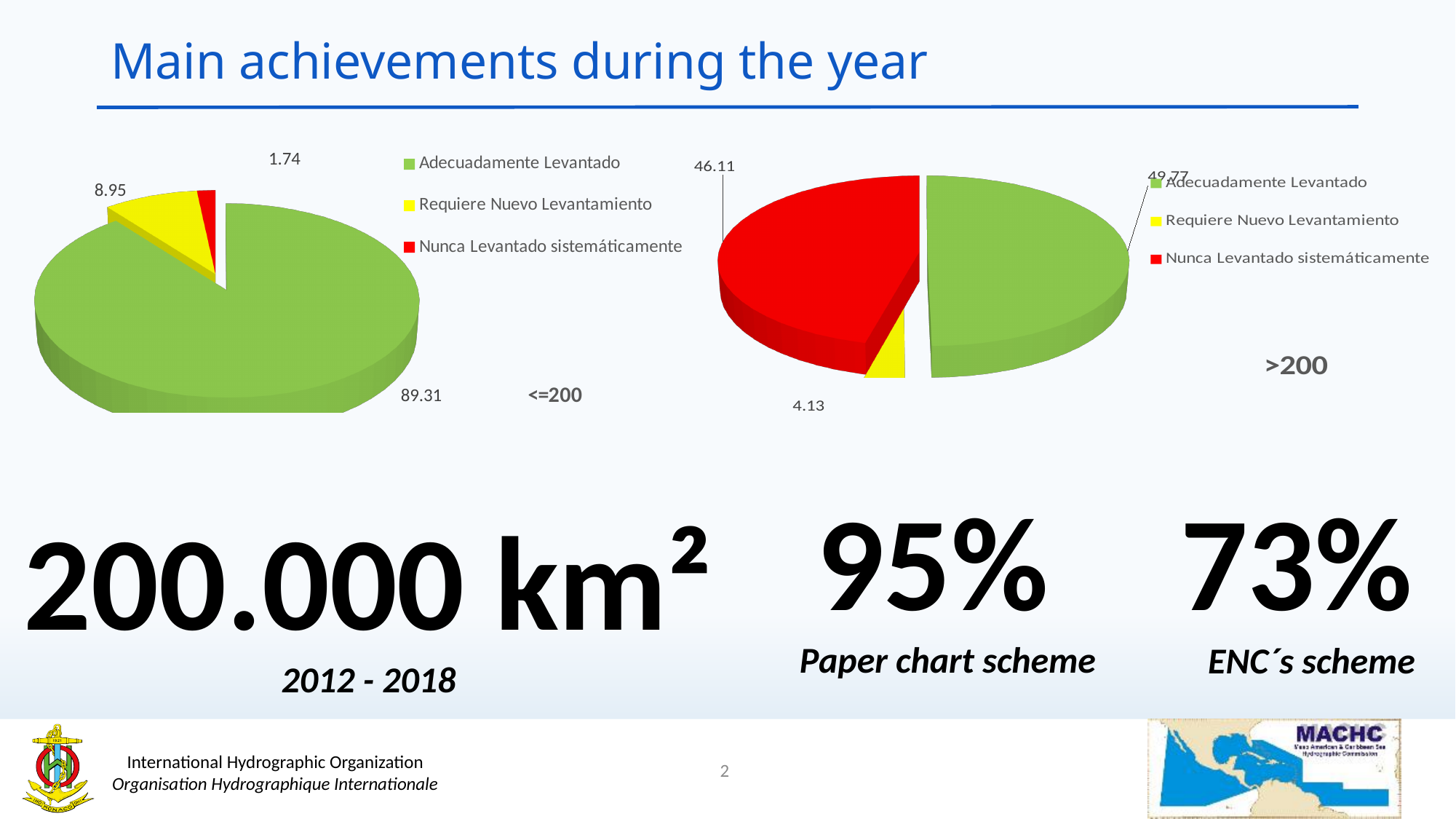
In the left pie chart (<=200), which is larger: Requiere Nuevo Levantamiento or Nunca Levantado sistemáticamente? Requiere Nuevo Levantamiento In the right pie chart (>200), what is the value for Requiere Nuevo Levantamiento? 4.13 What type of chart is the chart labelled <=200? Pie chart How many categories does the legend of the right pie chart (>200) list? 3 In the left pie chart (<=200), what is the value for Requiere Nuevo Levantamiento? 8.95 In the right pie chart (>200), what colour is the Nunca Levantado sistemáticamente slice? Red In the left pie chart (<=200), what is the value for Adecuadamente Levantado? 89.31 In the right pie chart (>200), what is the value for Nunca Levantado sistemáticamente? 46.11 In the right pie chart (>200), which category has the smallest slice? Requiere Nuevo Levantamiento In the left pie chart (<=200), which category has the largest slice? Adecuadamente Levantado In the left pie chart (<=200), what is the difference between the Requiere Nuevo Levantamiento and Nunca Levantado sistemáticamente values? 7.21 In the left pie chart (<=200), what is the value for Nunca Levantado sistemáticamente? 1.74